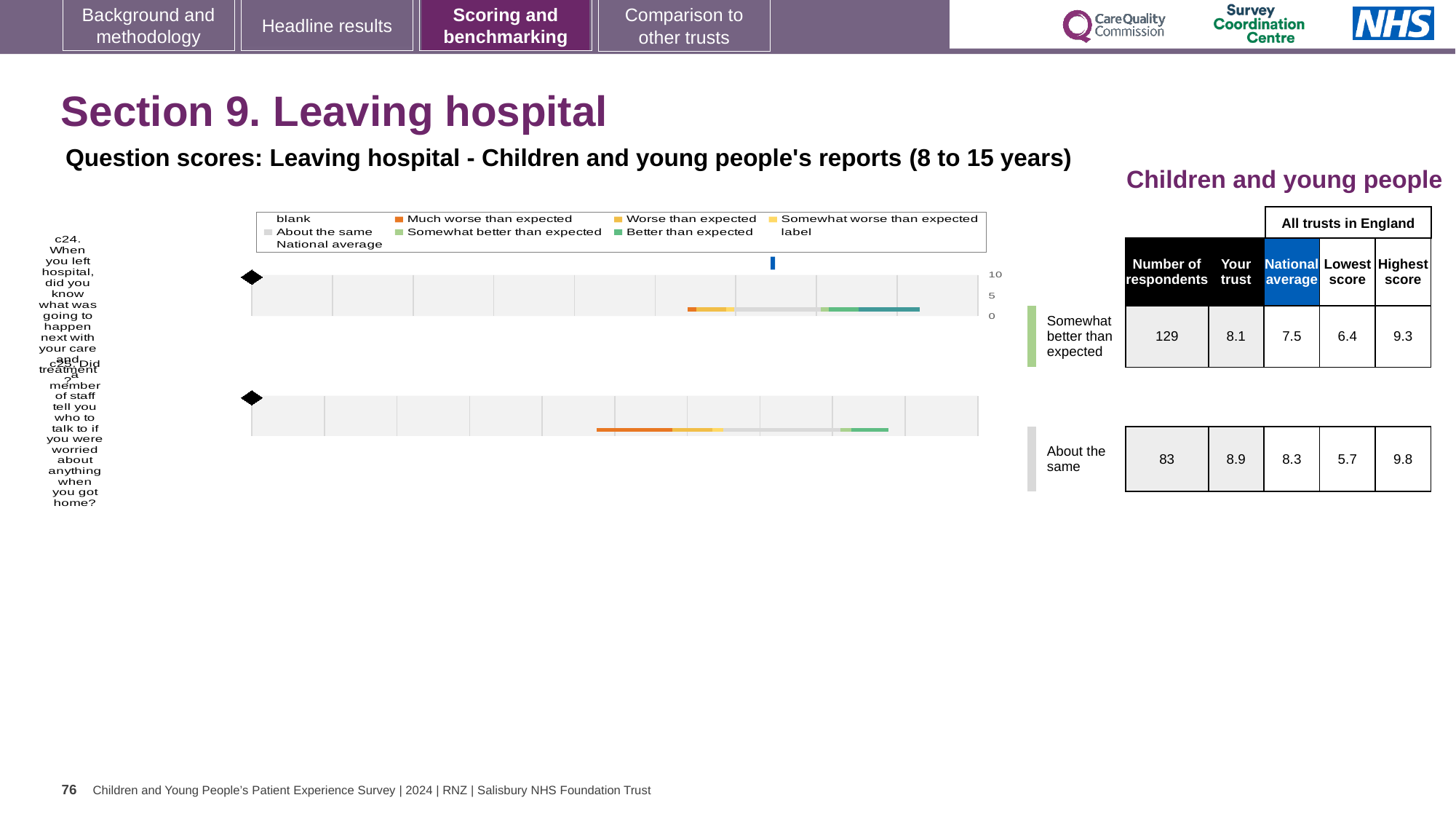
What is the national average score for question c25 (Did a member of staff tell you who to talk to if you were worried about anything when you got home?)? 8.3 How many respondents answered question c24? 129 What is the lowest score among all trusts in England for question c24? 6.4 By how much does the trust's score for c24 exceed the national average for c24? 0.6 Which question has the higher 'Your trust' score, c24 or c25? c25 What is the 'Your trust' score for question c24 (When you left hospital, did you know what was going to happen next with your care and treatment?)? 8.1 How many questions are plotted in the Leaving hospital chart? 2 Which benchmark category is question c25 placed in? About the same What is the difference between the highest and lowest scores for question c25? 4.1 What is the highest score among all trusts in England for question c25? 9.8 Which benchmark category is question c24 placed in? Somewhat better than expected What type of chart is used to show the question scores for Leaving hospital? bar chart